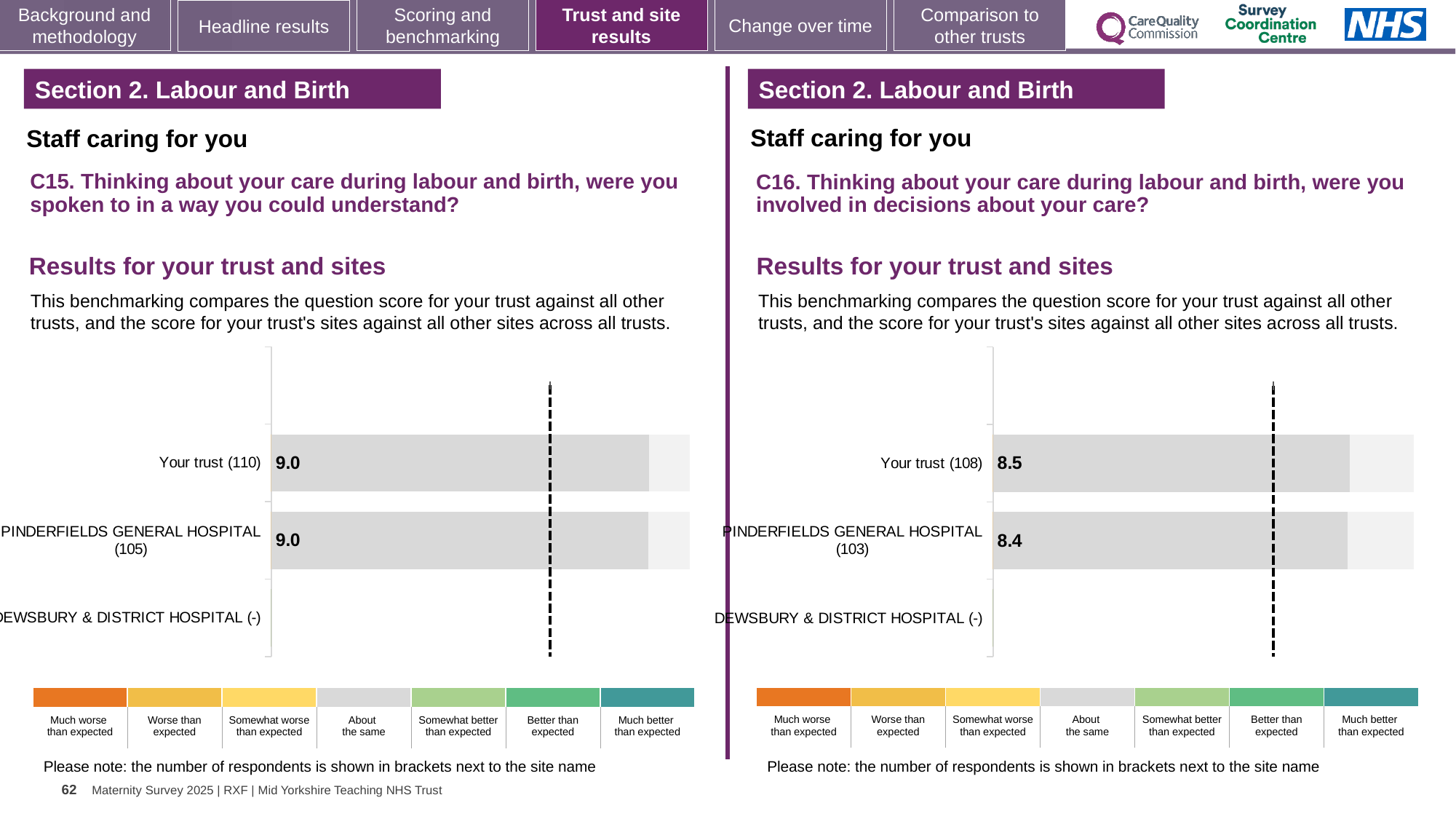
In the C16 chart on the right, which category has the lowest printed score? PINDERFIELDS GENERAL HOSPITAL (103) In the C15 chart on the left, what is the score for Your trust (110)? 9.0 What kind of chart is used in the C16 chart on the right? Bar chart In the C16 chart on the right, how many respondents are shown in brackets for PINDERFIELDS GENERAL HOSPITAL? 103 How many categories are listed on the vertical axis of the C15 chart on the left? 3 In the C16 chart on the right, what is the score for PINDERFIELDS GENERAL HOSPITAL (103)? 8.4 In the C16 chart on the right, what is the difference between the score for Your trust (108) and the score for PINDERFIELDS GENERAL HOSPITAL (103)? 0.1 In the C15 chart on the left, is the score for Your trust (110) the same as the score for PINDERFIELDS GENERAL HOSPITAL (105)? Yes In the C15 chart on the left, what is the score for PINDERFIELDS GENERAL HOSPITAL (105)? 9.0 In the C16 chart on the right, what is the score for Your trust (108)? 8.5 In the C15 chart on the left, how many respondents are shown in brackets for Your trust? 110 In the C16 chart on the right, which has the higher score: Your trust (108) or PINDERFIELDS GENERAL HOSPITAL (103)? Your trust (108)